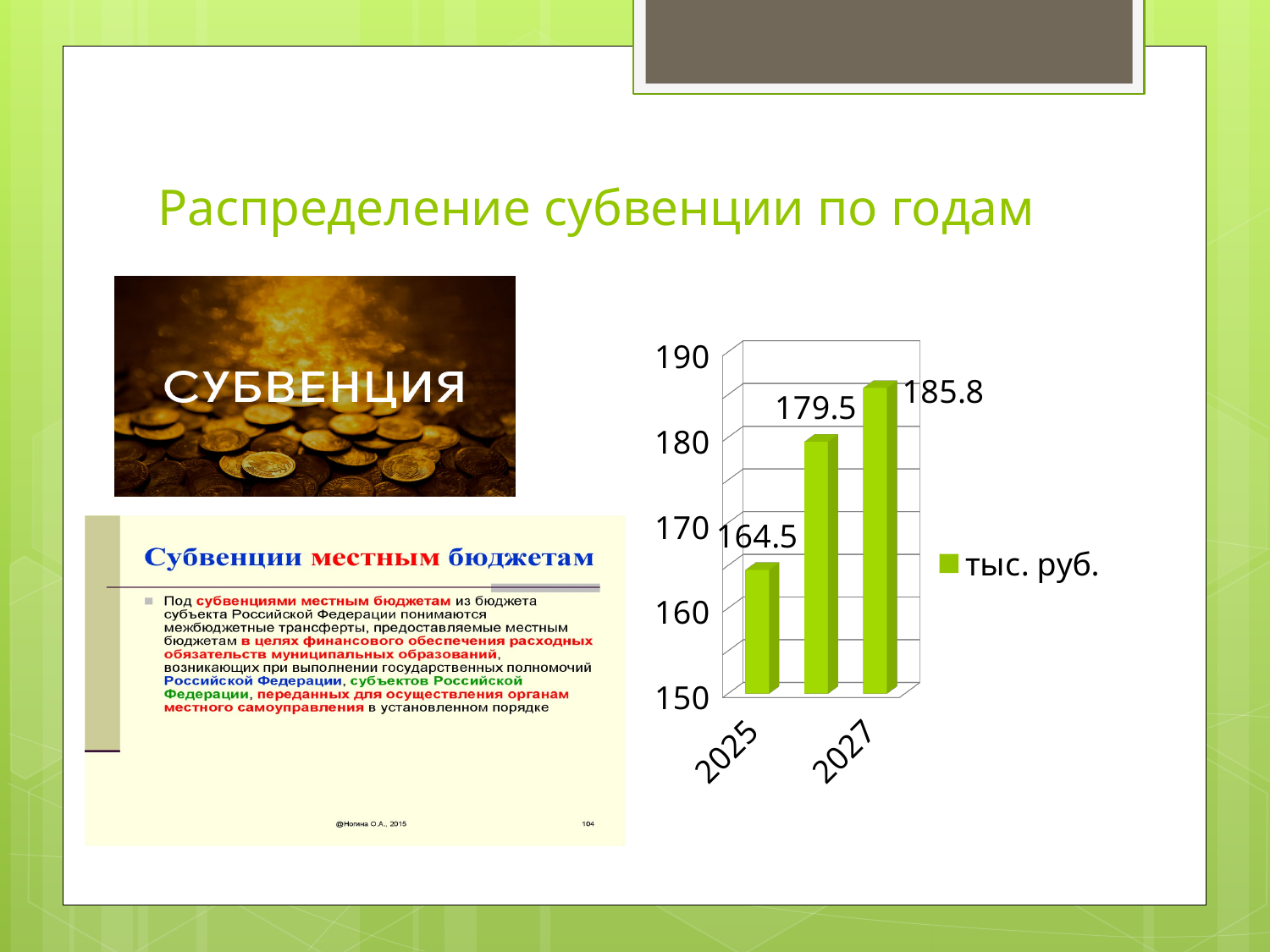
How many bars are plotted in the chart? 3 How many series does the legend list? 1 What kind of chart is shown on the slide? bar chart What is the difference between the values for 2027 and 2025? 21.3 Which is larger, the value for 2025 or the value for 2027? 2027 What is the value for 2027? 185.8 Is the value for 2025 greater or less than 170? less Is the value for 2027 greater or less than 180? greater Which year has the highest value? 2027 Which year has the lowest value? 2025 Do the values rise or fall from left to right along the x axis? rise What is the value for 2025? 164.5